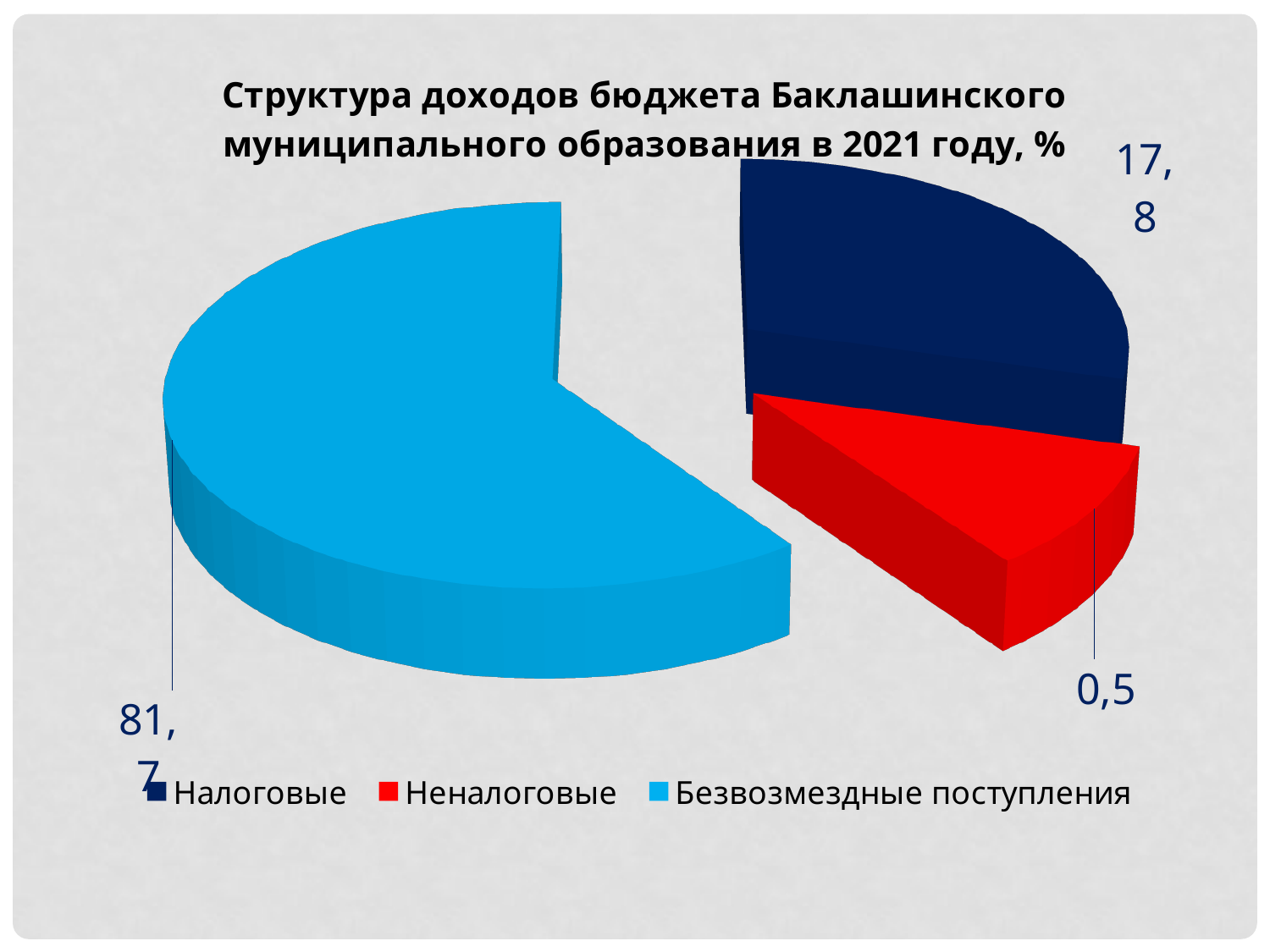
What is the value for Налоговые? 17,8 What is the difference between the values for Безвозмездные поступления and Налоговые? 63,9 What is the value for Неналоговые? 0,5 Which is larger, Налоговые or Неналоговые? Налоговые What kind of chart is shown on the slide? Pie chart What is the difference between the values for Налоговые and Неналоговые? 17,3 Which category has the largest slice of the pie? Безвозмездные поступления What is the title of the chart? Структура доходов бюджета Баклашинского муниципального образования в 2021 году, % Which category has the smallest slice of the pie? Неналоговые How many entries does the legend list? 3 How many slices does the pie chart have? 3 What is the value for Безвозмездные поступления? 81,7